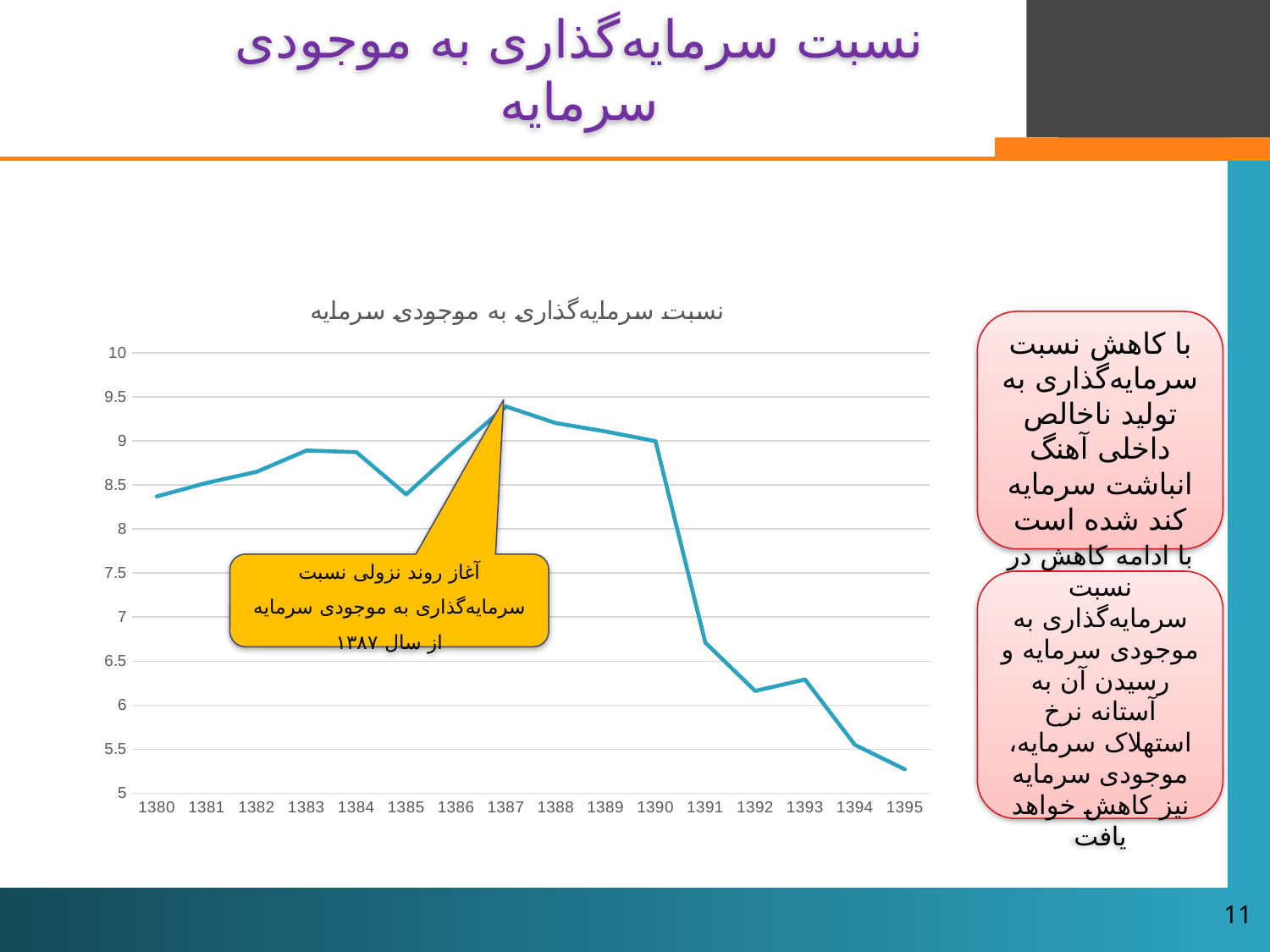
Do the values rise or fall from 1390 to 1395? fall In which year does the line reach its highest value? 1387 Which year has the larger value, 1385 or 1386? 1386 How many years are plotted along the x axis of the chart? 16 Is the value for 1387 greater or less than 9? greater Is the value for 1395 greater or less than 5.5? less In which year does the line reach its lowest value? 1395 Is the value for 1391 greater or less than 7? less What is the title of the chart? نسبت سرمایه‌گذاری به موجودی سرمایه What kind of chart is shown on the slide? line chart Which year has the larger value, 1387 or 1395? 1387